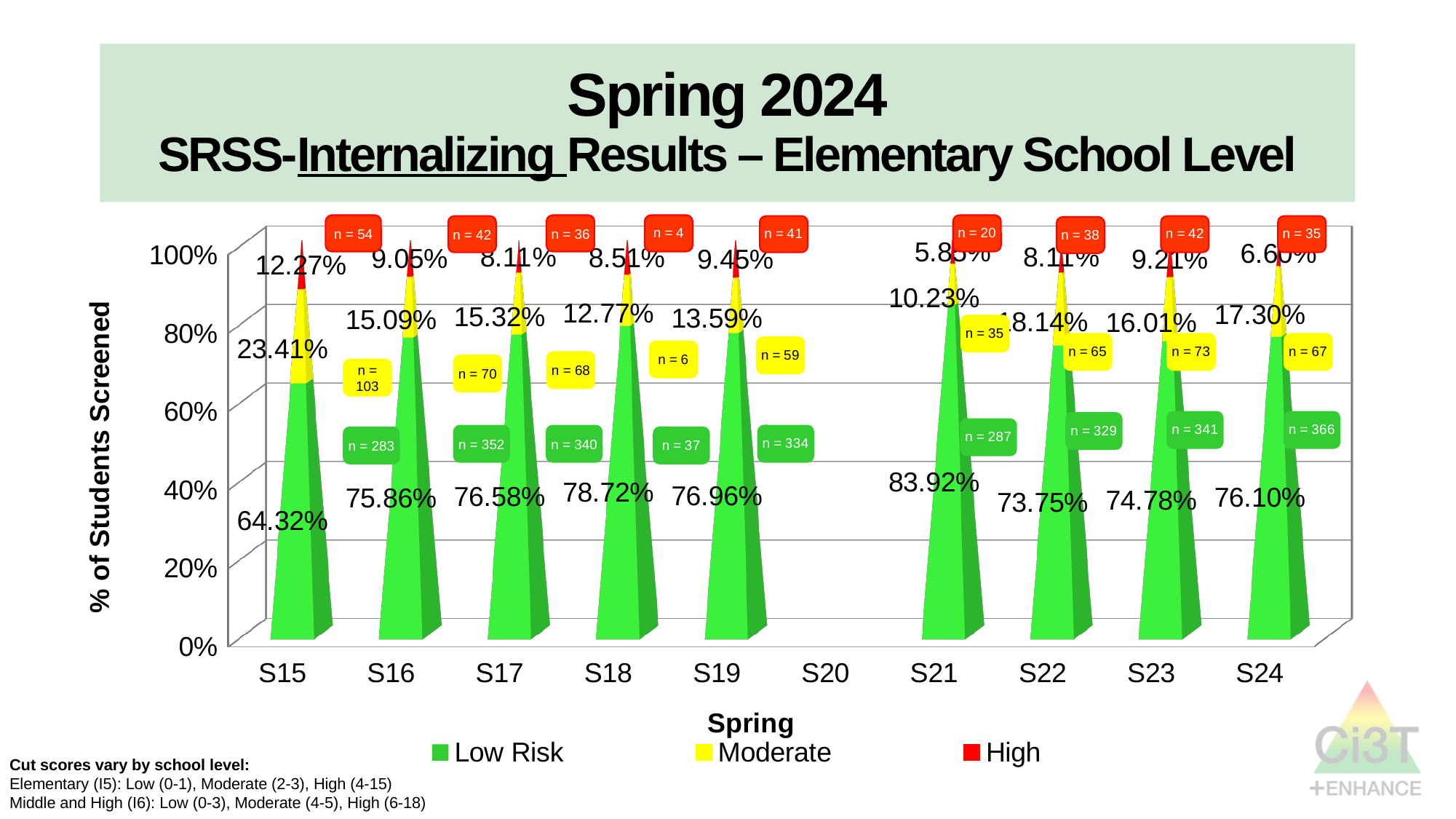
How many series does the legend list? 3 How many students were screened as Low Risk at S24 (n value)? n = 366 What is the Moderate percentage for S22? 18.14% What is the High percentage for S19? 9.45% Which school has the lowest Low Risk percentage? S15 Which is larger, the Moderate percentage for S23 or for S19? S23 What is the Low Risk percentage for S15? 64.32% Which school has the highest Moderate percentage? S15 What is the difference between the Low Risk percentages of S18 and S17? 2.14% What type of chart is shown on the slide? bar chart Which school on the x axis has no data plotted? S20 Which school has the highest Low Risk percentage? S21